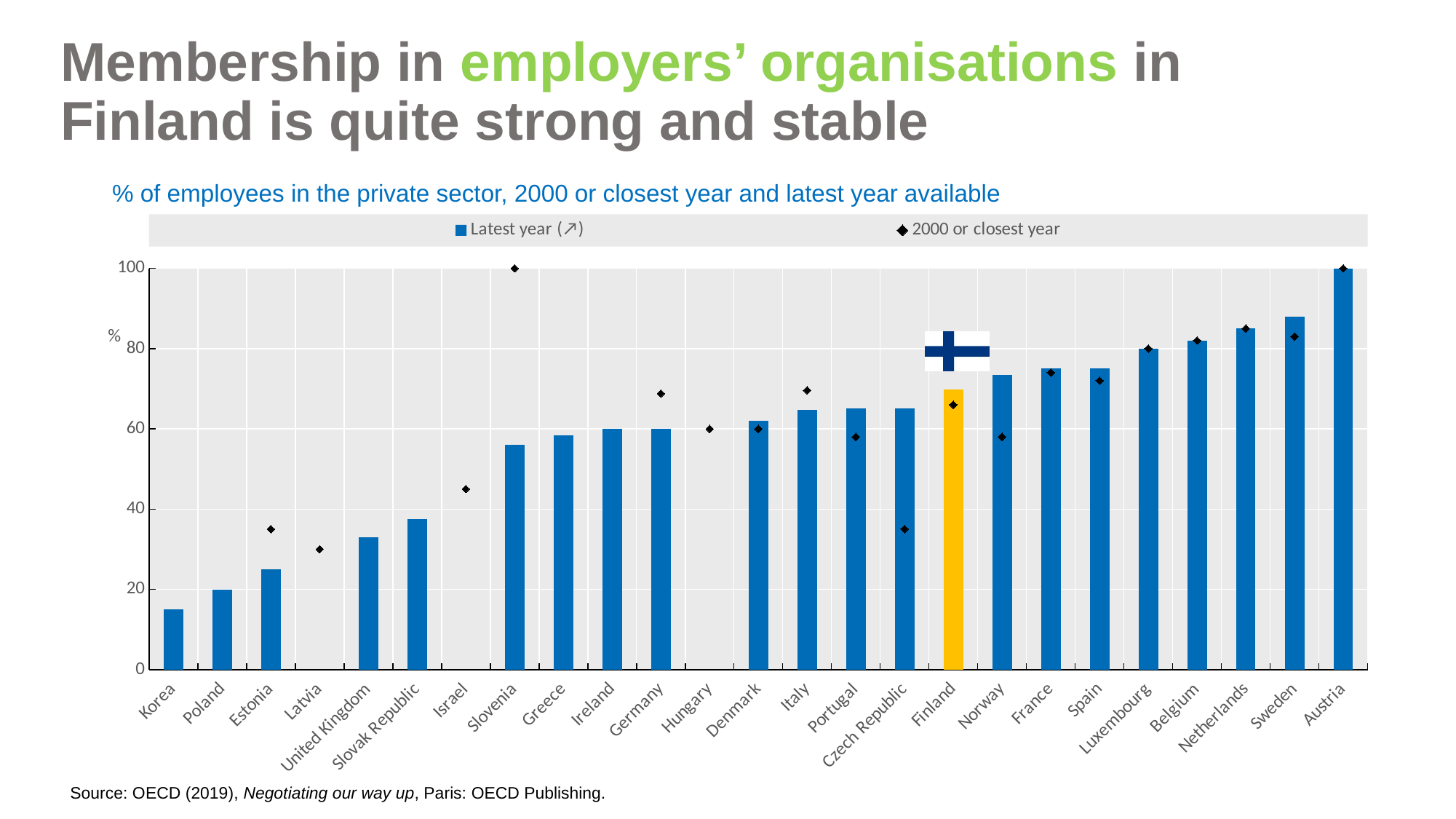
Which country has the lowest latest-year bar? Korea Which country has the highest latest-year bar? Austria Do the latest-year bars generally rise or fall from left to right along the x axis? Rise What kind of chart is shown on the slide? Bar chart Which has the larger latest-year bar, Estonia or Poland? Estonia Is the latest-year value for Sweden greater or less than 80? greater Is the latest-year value for Korea greater or less than 20? less Is the 2000 or closest year value for the Czech Republic greater or less than 40? less Which country's bar is highlighted in a different colour (yellow) from the others? Finland How many series does the legend list? 2 How many countries are shown on the x axis? 25